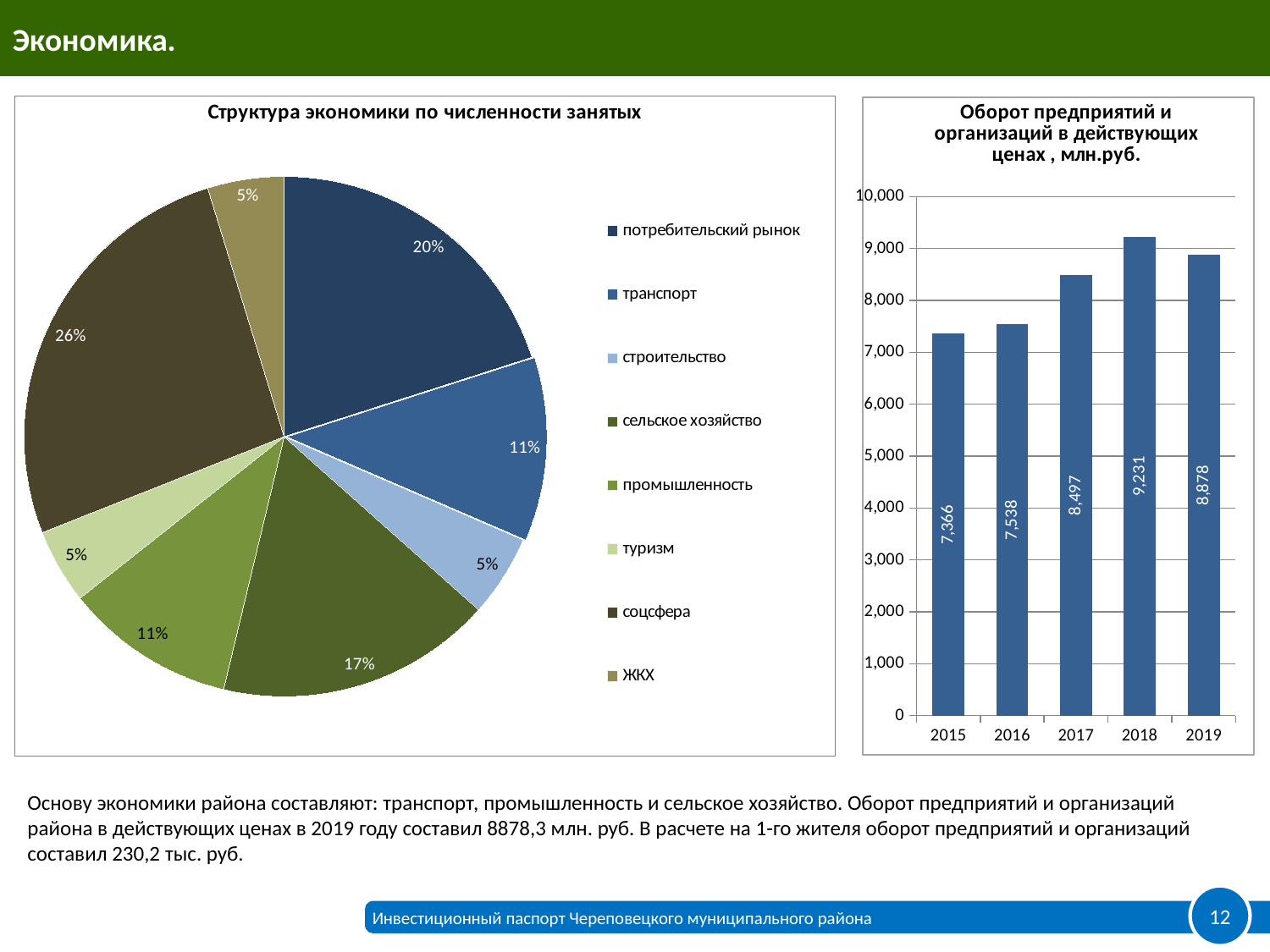
In the pie chart 'Структура экономики по численности занятых', what share does сельское хозяйство have? 17% In the bar chart 'Оборот предприятий и организаций в действующих ценах, млн.руб.', is the value for 2017 greater or less than 8,000? greater In the bar chart 'Оборот предприятий и организаций в действующих ценах, млн.руб.', which year has the highest value? 2018 In the bar chart 'Оборот предприятий и организаций в действующих ценах, млн.руб.', which year has the lowest value? 2015 What type of chart is the chart on the right side of the slide? bar chart In the bar chart 'Оборот предприятий и организаций в действующих ценах, млн.руб.', what is the difference between the values for 2018 and 2019? 353 In the bar chart 'Оборот предприятий и организаций в действующих ценах, млн.руб.', what is the value for 2015? 7,366 In the pie chart 'Структура экономики по численности занятых', what share does соцсфера have? 26% In the bar chart 'Оборот предприятий и организаций в действующих ценах, млн.руб.', how many years are shown? 5 In the pie chart 'Структура экономики по численности занятых', how many categories does the legend list? 8 In the bar chart 'Оборот предприятий и организаций в действующих ценах, млн.руб.', what is the value for 2018? 9,231 In the pie chart 'Структура экономики по численности занятых', which category has the largest share? соцсфера